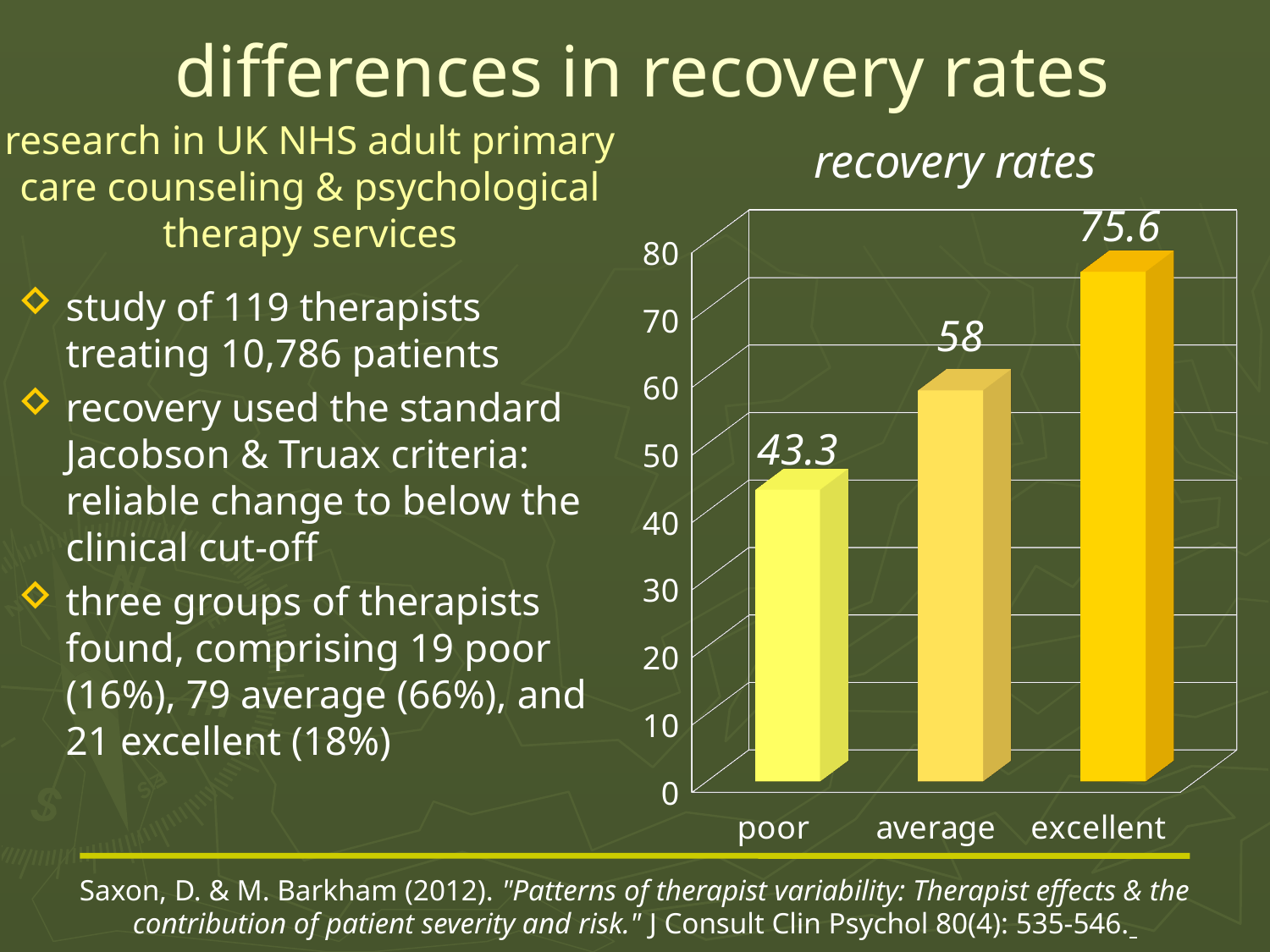
Which therapist group has the lowest recovery rate? poor Which has a higher recovery rate, the average group or the poor group? average What is the recovery rate for the average therapist group? 58 What is the difference between the recovery rates of the excellent and poor groups? 32.3 What is the recovery rate for the poor therapist group? 43.3 How many therapist groups are shown in the chart? 3 What is the recovery rate for the excellent therapist group? 75.6 What is the title of the chart? recovery rates What kind of chart is used to show the recovery rates? bar chart What is the difference between the recovery rates of the average and poor groups? 14.7 Which therapist group has the highest recovery rate? excellent Is the recovery rate for the average group greater or less than 50? greater